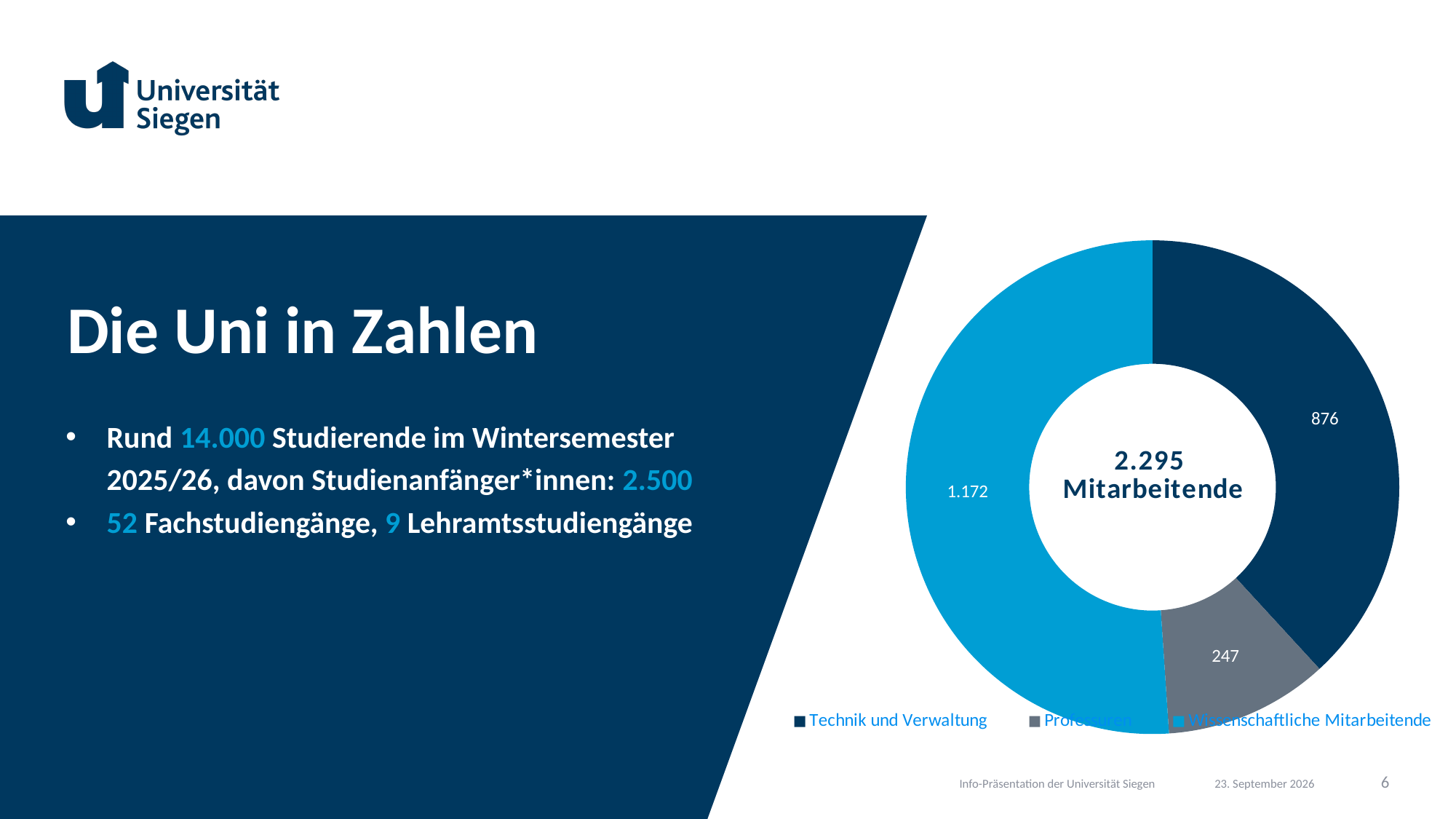
What value is shown for Technik und Verwaltung in the doughnut chart? 876 What total number is printed in the centre of the doughnut chart? 2.295 Mitarbeitende How many categories does the doughnut chart show? 3 Which category has the smallest slice in the doughnut chart? Professuren Which category is shown in grey in the doughnut chart? Professuren What value is shown for Professuren in the doughnut chart? 247 Which is larger: the value for Technik und Verwaltung or the value for Professuren? Technik und Verwaltung Which category has the largest slice in the doughnut chart? Wissenschaftliche Mitarbeitende What value is shown for Wissenschaftliche Mitarbeitende in the doughnut chart? 1.172 What is the difference between the values for Wissenschaftliche Mitarbeitende and Technik und Verwaltung? 296 What kind of chart is shown on the slide? doughnut chart What is the difference between the values for Technik und Verwaltung and Professuren? 629